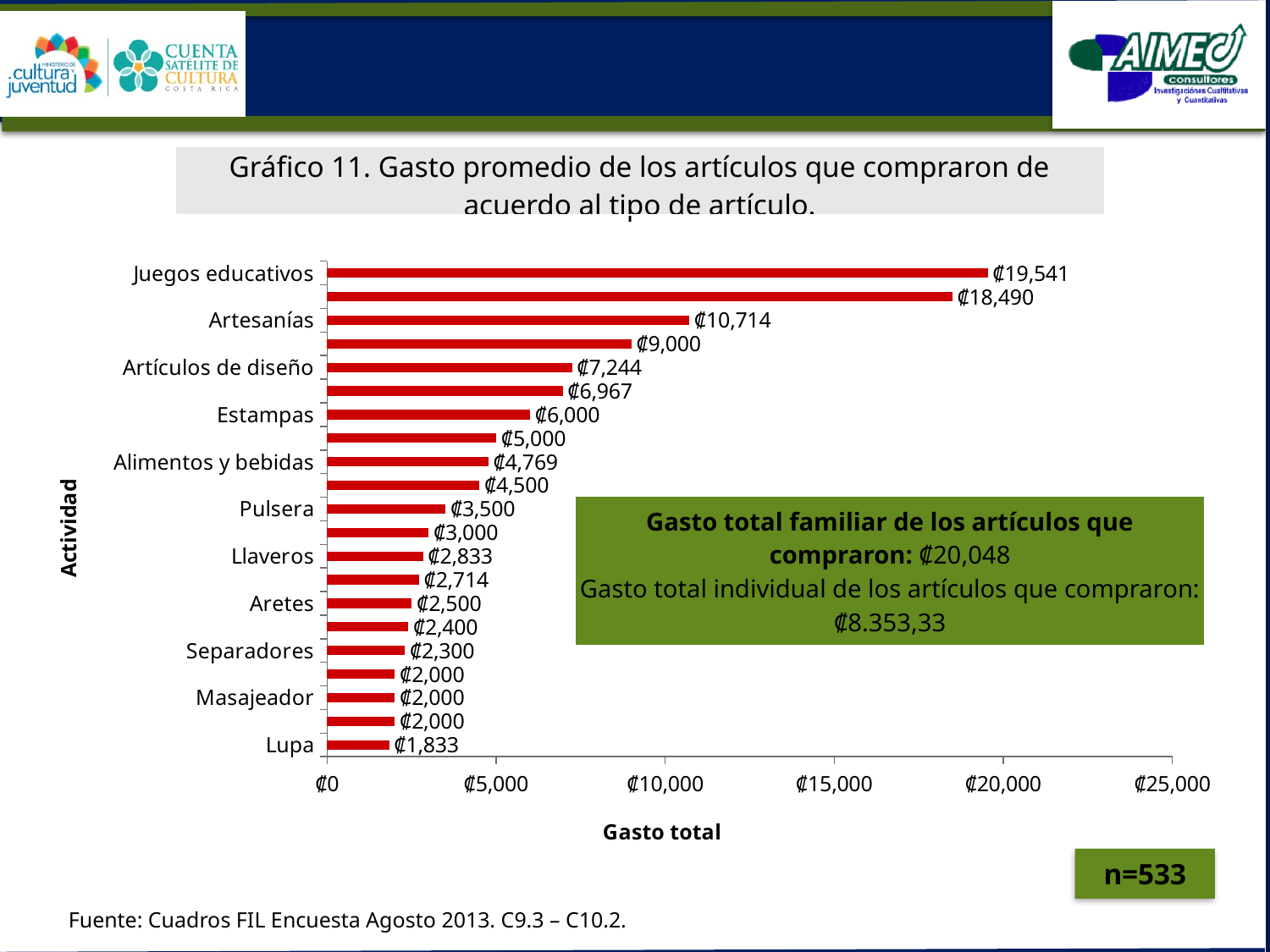
Which is larger, the value for Estampas or the value for Pulsera? Estampas Which category has the highest value? Juegos educativos What is the value for Alimentos y bebidas? ₡4,769 What is the difference between the values for Juegos educativos and Artesanías? ₡8,827 How many bars are plotted in the chart? 21 Which category has the lowest value? Lupa What is the value for Artesanías? ₡10,714 What is the value for Lupa? ₡1,833 What kind of chart is shown on the slide? Bar chart Is the value for Artículos de diseño greater or less than ₡5,000? greater What is the title of the horizontal axis? Gasto total What is the value for Juegos educativos? ₡19,541